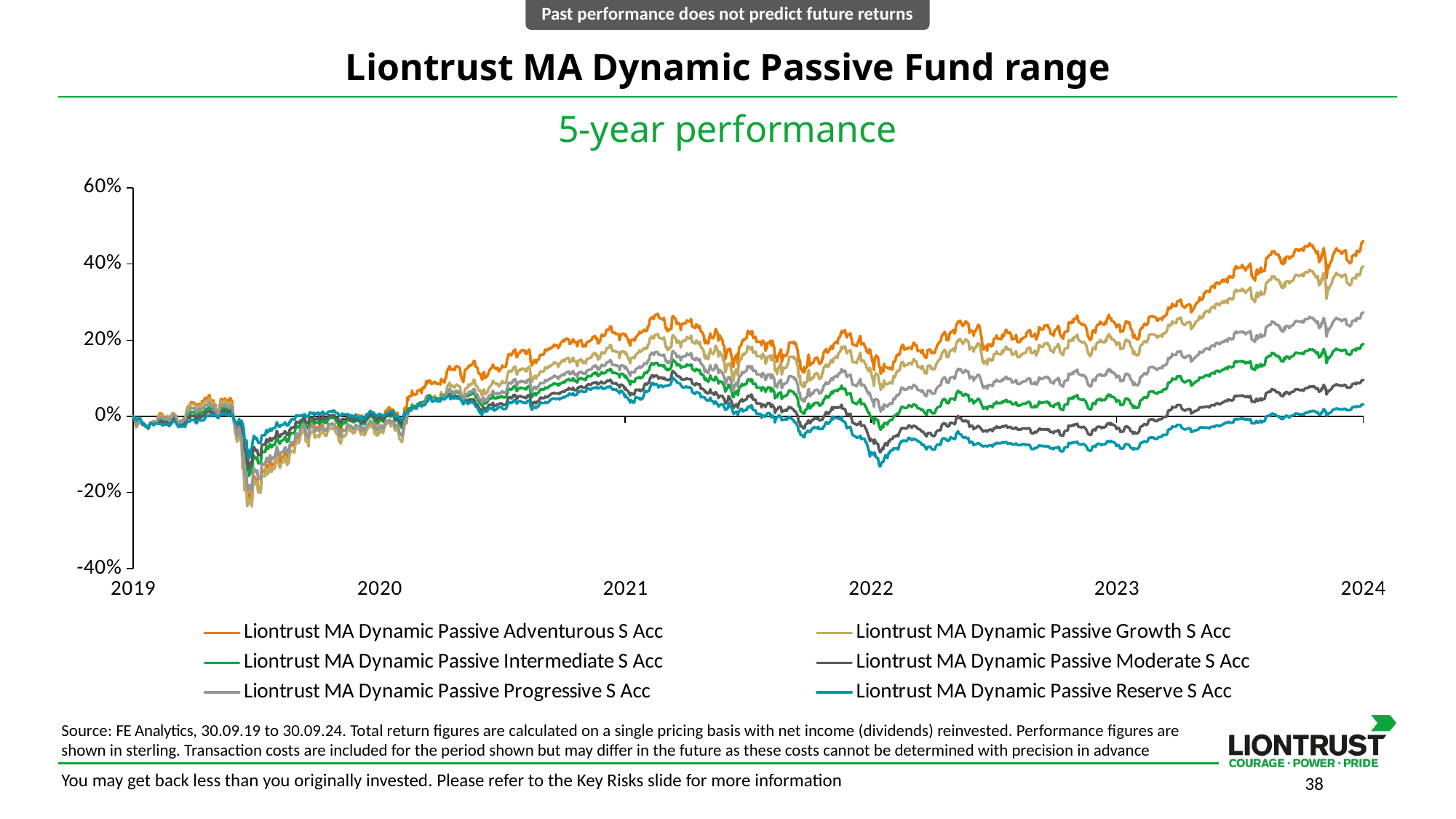
Is the value for Liontrust MA Dynamic Passive Adventurous S Acc at the end of 2024 greater or less than 40%? greater Does the Liontrust MA Dynamic Passive Adventurous S Acc line rise or fall between 2023 and 2024? Rise Which series has the lowest value at the end of the chart in 2024? Liontrust MA Dynamic Passive Reserve S Acc Which series has the highest value at the end of the chart in 2024? Liontrust MA Dynamic Passive Adventurous S Acc Is the value for Liontrust MA Dynamic Passive Growth S Acc at the end of 2024 greater or less than 20%? greater Is the value for Liontrust MA Dynamic Passive Reserve S Acc at the end of 2024 greater or less than 20%? less What colour is the line for Liontrust MA Dynamic Passive Adventurous S Acc? Orange What kind of chart is shown on the slide? Line chart How many series does the legend list? 6 At the end of 2024, which is larger: Liontrust MA Dynamic Passive Growth S Acc or Liontrust MA Dynamic Passive Intermediate S Acc? Liontrust MA Dynamic Passive Growth S Acc What is the title of the chart? 5-year performance How many year labels are shown on the x axis? 6